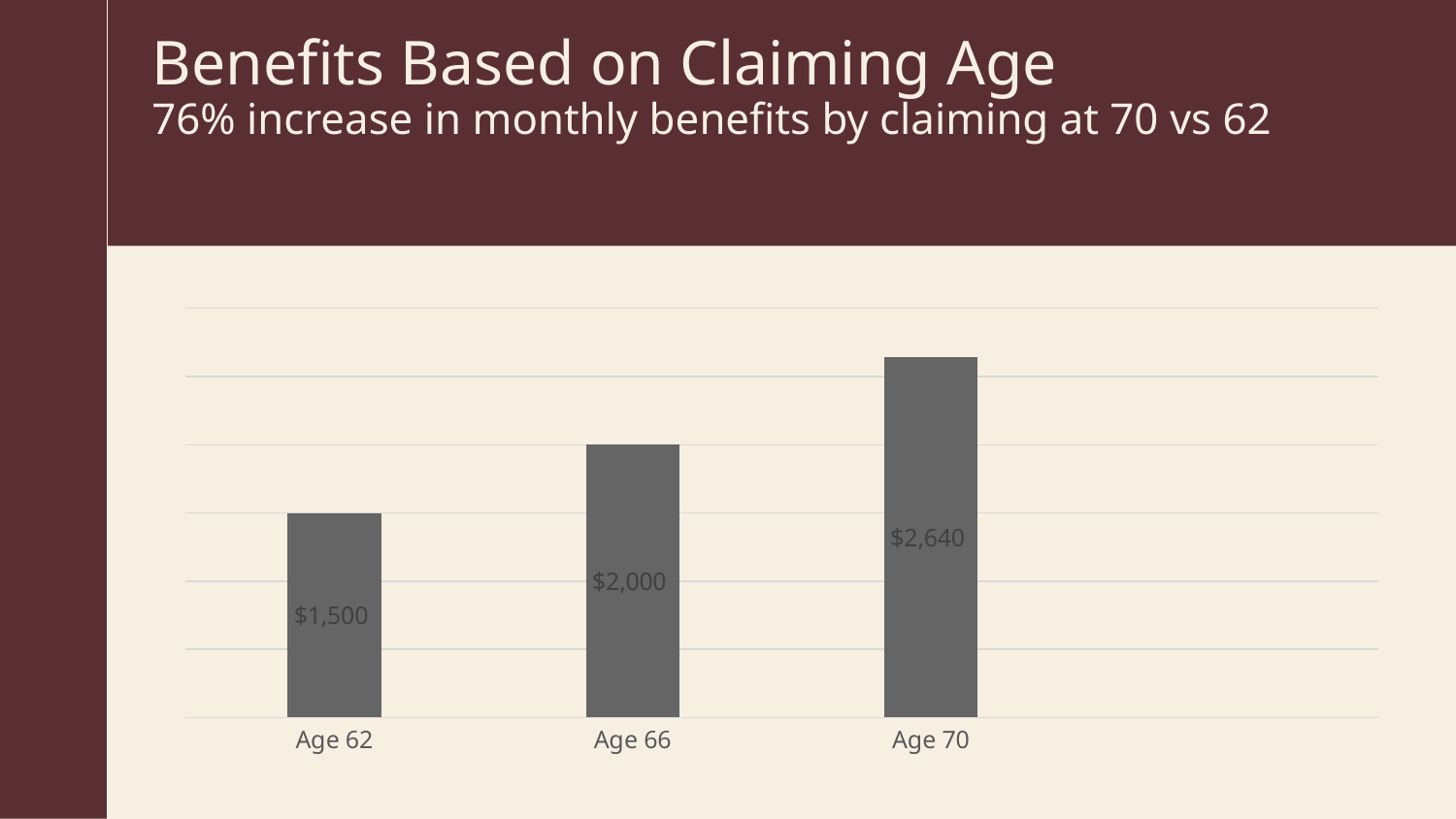
What is the difference between the benefit at Age 70 and the benefit at Age 62? $1,140 What is the monthly benefit value shown for Age 70? $2,640 Which is larger, the benefit at Age 66 or the benefit at Age 70? Age 70 What is the title of the slide containing the chart? Benefits Based on Claiming Age What is the difference between the benefit at Age 66 and the benefit at Age 62? $500 Which claiming age has the lowest monthly benefit? Age 62 What kind of chart is shown on the slide? Bar chart How many claiming ages are shown in the chart? 3 Which claiming age has the highest monthly benefit? Age 70 What is the monthly benefit value shown for Age 66? $2,000 Do the benefit values rise or fall as claiming age increases from Age 62 to Age 70? Rise What is the monthly benefit value shown for Age 62? $1,500